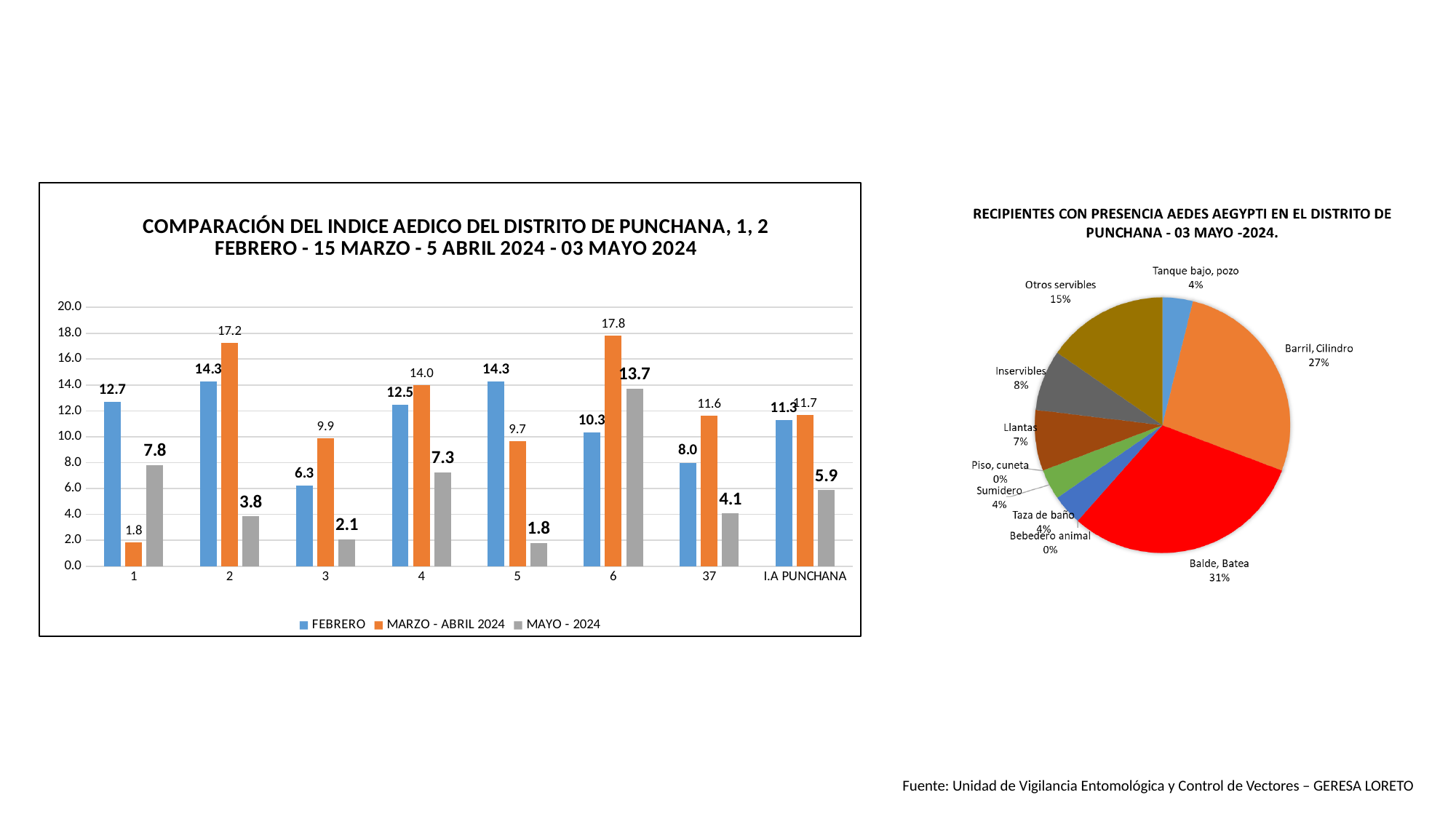
What kind of chart is the chart on the right of the slide? Pie chart In the bar chart on the left, which is larger for category 5: the FEBRERO value or the MARZO - ABRIL 2024 value? FEBRERO In the bar chart on the left, what is the difference between the MARZO - ABRIL 2024 and FEBRERO values for category 2? 2.9 In the pie chart on the right, which category has the largest share? Balde, Batea In the bar chart on the left, which category has the lowest FEBRERO value? 3 In the pie chart on the right, what share does Otros servibles have? 15% In the bar chart on the left, what is the FEBRERO value for I.A PUNCHANA? 11.3 In the pie chart on the right, what share does Balde, Batea have? 31% How many categories are shown on the x axis of the bar chart on the left? 8 How many series does the legend of the bar chart on the left list? 3 In the bar chart on the left, which category has the highest MARZO - ABRIL 2024 value? 6 In the bar chart on the left, what is the MAYO - 2024 value for category 6? 13.7